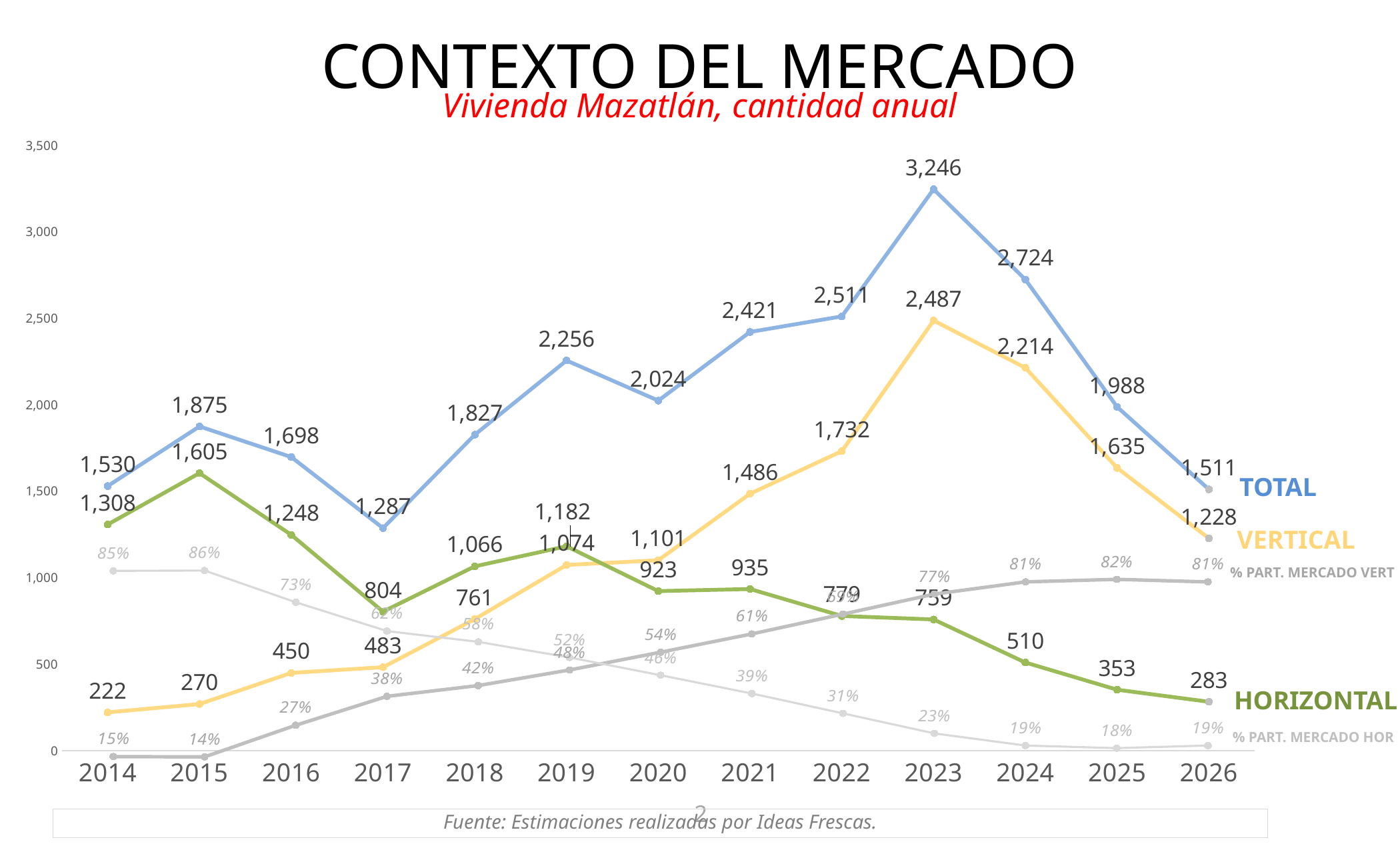
What type of chart is shown on the slide? Line chart In which year is the TOTAL series lowest? 2017 What is the red subtitle of the chart? Vivienda Mazatlán, cantidad anual Does the HORIZONTAL series rise or fall from 2023 to 2026? Fall What is the VERTICAL value for 2023? 2,487 How many years are plotted on the x axis? 13 In which year is the TOTAL series highest? 2023 In 2019, which is larger, the HORIZONTAL value or the VERTICAL value? HORIZONTAL What is the % PART. MERCADO VERT value for 2025? 82% What is the HORIZONTAL value for 2026? 283 What is the TOTAL value for 2023? 3,246 What is the difference between the TOTAL values for 2023 and 2024? 522